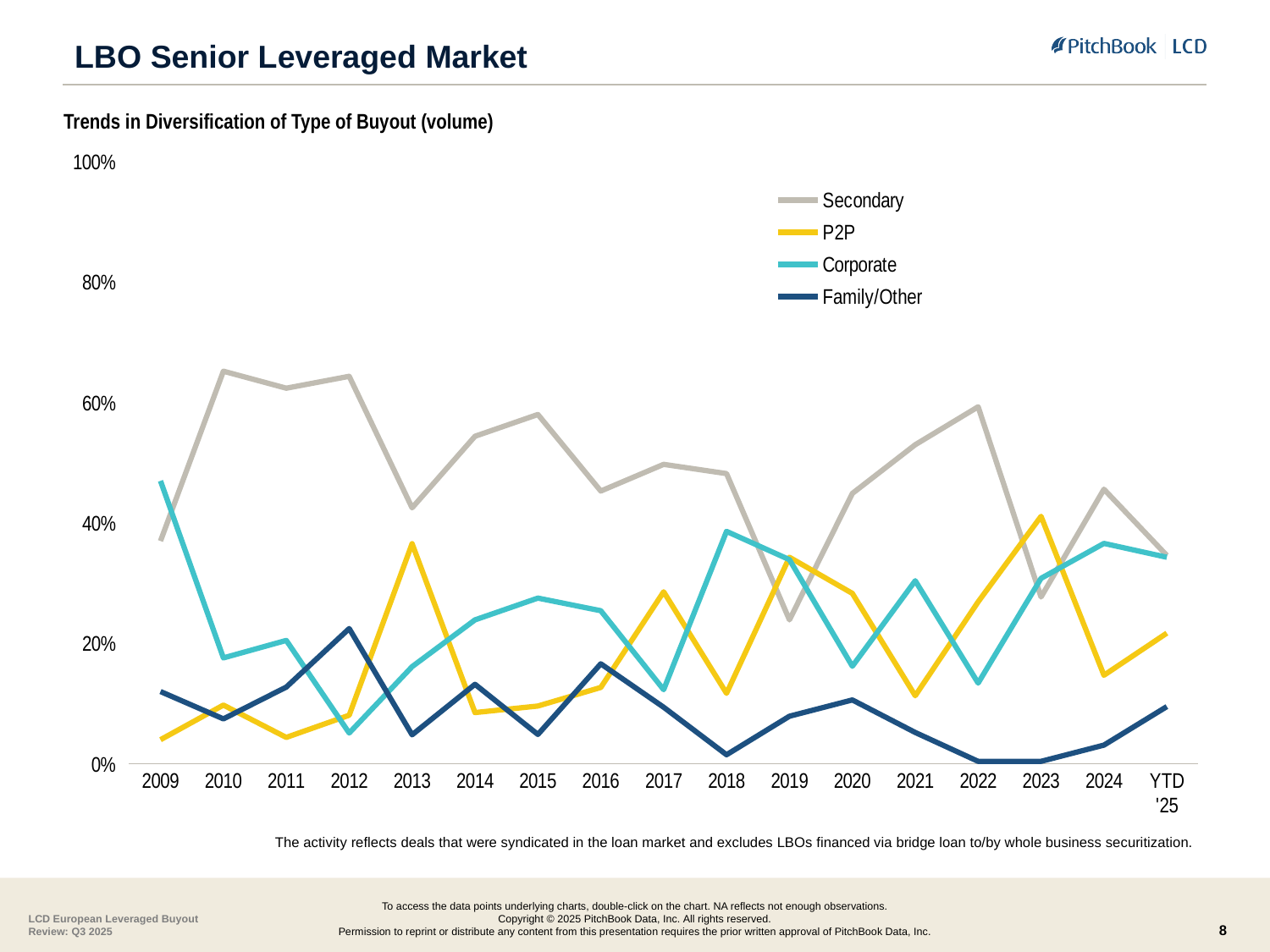
What type of chart is shown on the slide? Line chart Is the value for Secondary in 2010 greater or less than 60%? greater How many time periods are shown on the x axis? 17 Which series has the highest value in 2010? Secondary Is the value for P2P in 2009 greater or less than 20%? less Is the value for Family/Other in 2022 greater or less than 20%? less Which series is shown in yellow in the legend? P2P How many series does the legend list? 4 In 2009, which is larger: Secondary or Corporate? Corporate Which series has the lowest value in 2022? Family/Other What is the title of the chart? Trends in Diversification of Type of Buyout (volume)